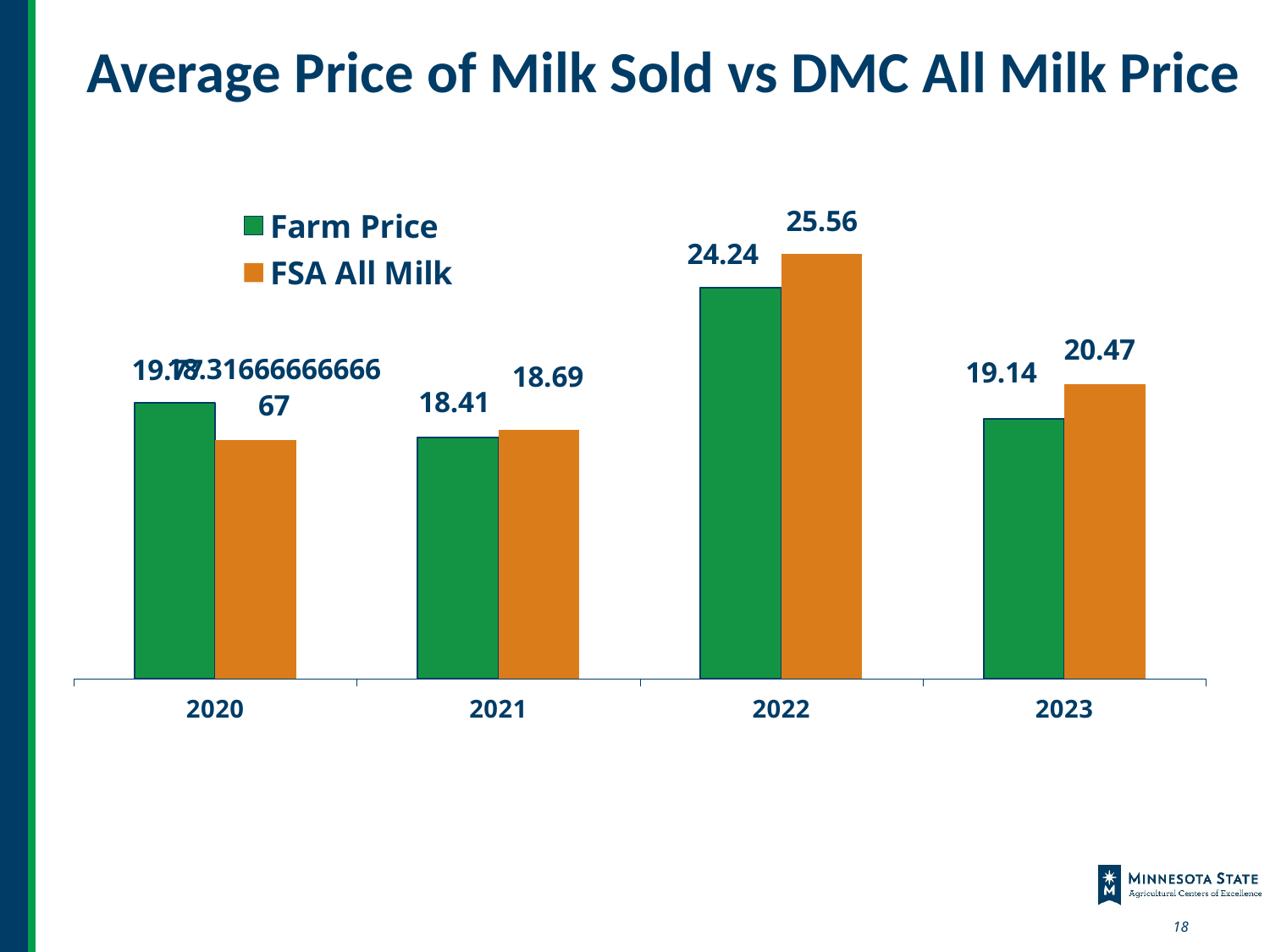
How many series does the legend list? 2 What is the Farm Price value for 2022? 24.24 What is the FSA All Milk value for 2023? 20.47 In which year is the FSA All Milk value highest? 2022 What is the difference between the FSA All Milk and Farm Price values in 2022? 1.32 What is the difference between the FSA All Milk and Farm Price values in 2023? 1.33 What kind of chart is shown on the slide? Bar chart In which year is the Farm Price value lowest? 2021 In 2020, which is larger: Farm Price or FSA All Milk? Farm Price What is the Farm Price value for 2021? 18.41 How many years are shown on the x axis? 4 What is the FSA All Milk value for 2022? 25.56